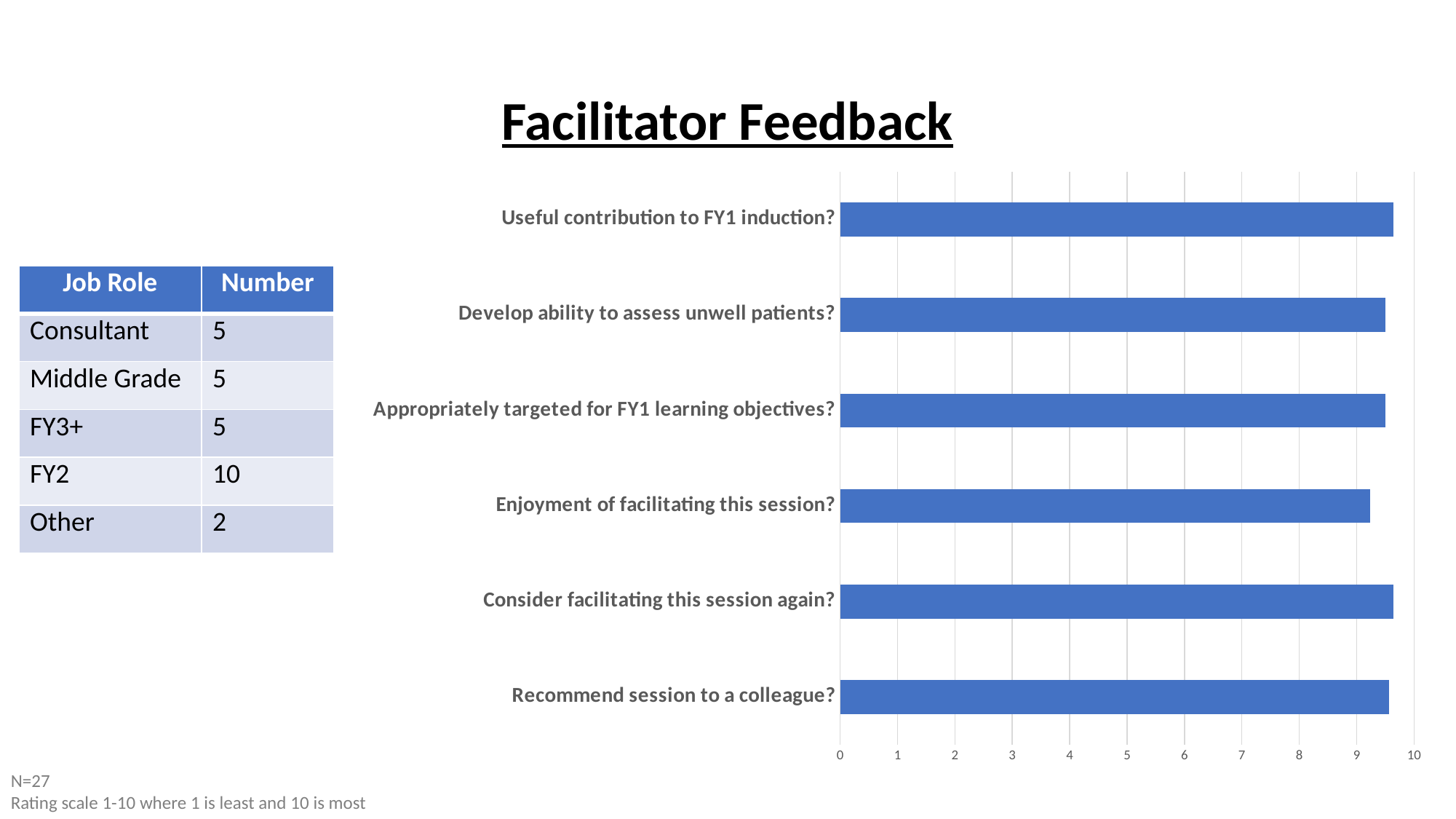
Which category has the lowest value in the bar chart? Enjoyment of facilitating this session? Is the value for "Consider facilitating this session again?" greater or less than 10? less Is the value for "Useful contribution to FY1 induction?" greater or less than 9? greater How many questions (categories) are plotted in the bar chart? 6 Is the value for "Develop ability to assess unwell patients?" greater or less than 9? greater Which is larger: the value for "Useful contribution to FY1 induction?" or the value for "Enjoyment of facilitating this session?"? Useful contribution to FY1 induction? What is the title of the slide containing the bar chart? Facilitator Feedback What kind of chart is shown on the slide? bar chart What is the maximum value shown on the horizontal axis of the bar chart? 10